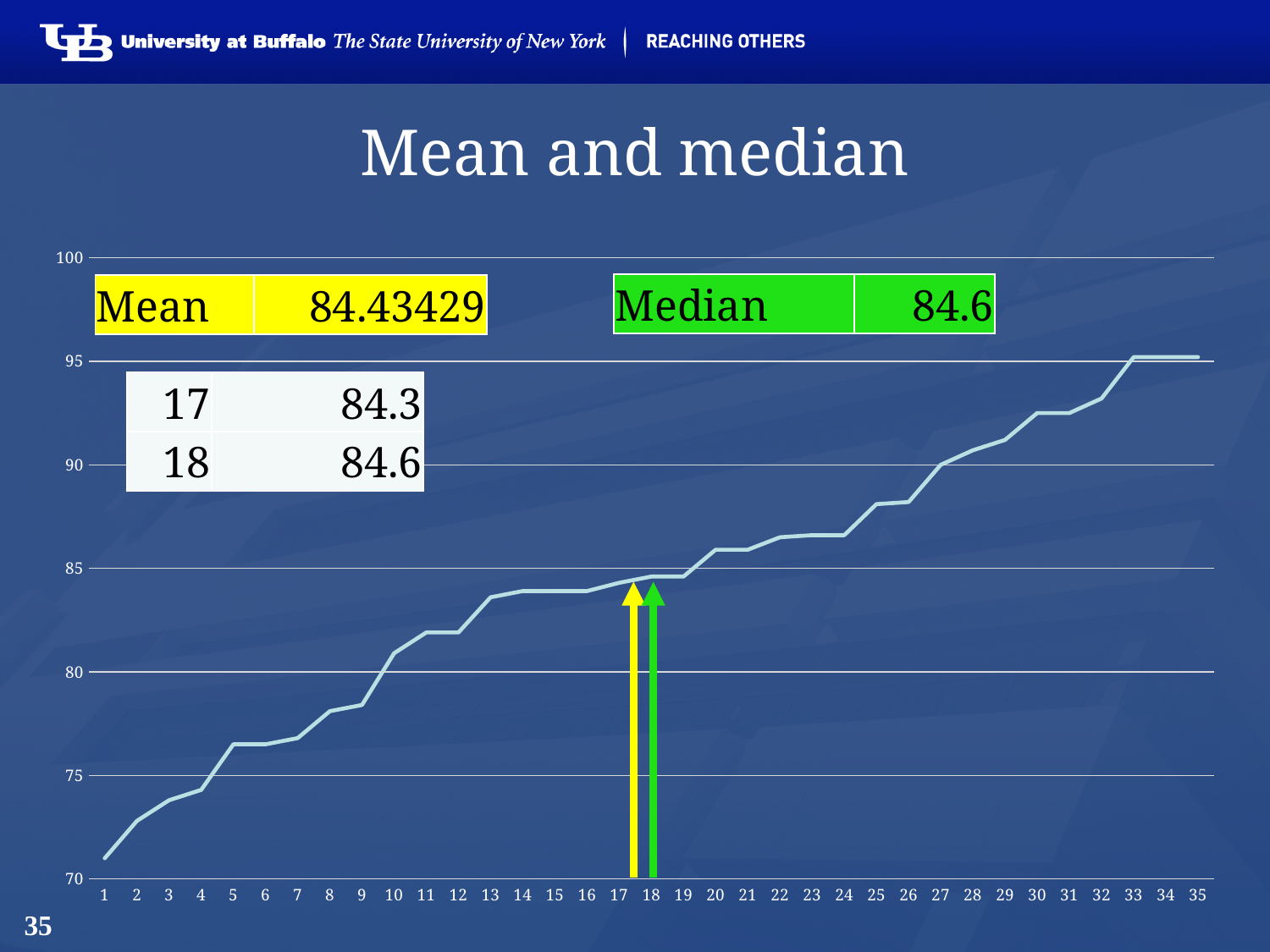
What mean value is shown on the slide? 84.43429 Is the value for point 1 greater or less than 75? less What median value is shown on the slide? 84.6 What is the title of the slide containing the chart? Mean and median What is the value for point 17, as shown in the table on the slide? 84.3 How many data points are plotted along the x axis? 35 Which has the larger value, point 17 or point 18? 18 Do the plotted values rise or fall as you move from 1 to 35 along the x axis? rise What is the difference between the values for points 18 and 17? 0.3 Is the value for point 27 greater or less than 85? greater What is the value for point 18, as shown in the table on the slide? 84.6 What kind of chart is shown on the slide? line chart